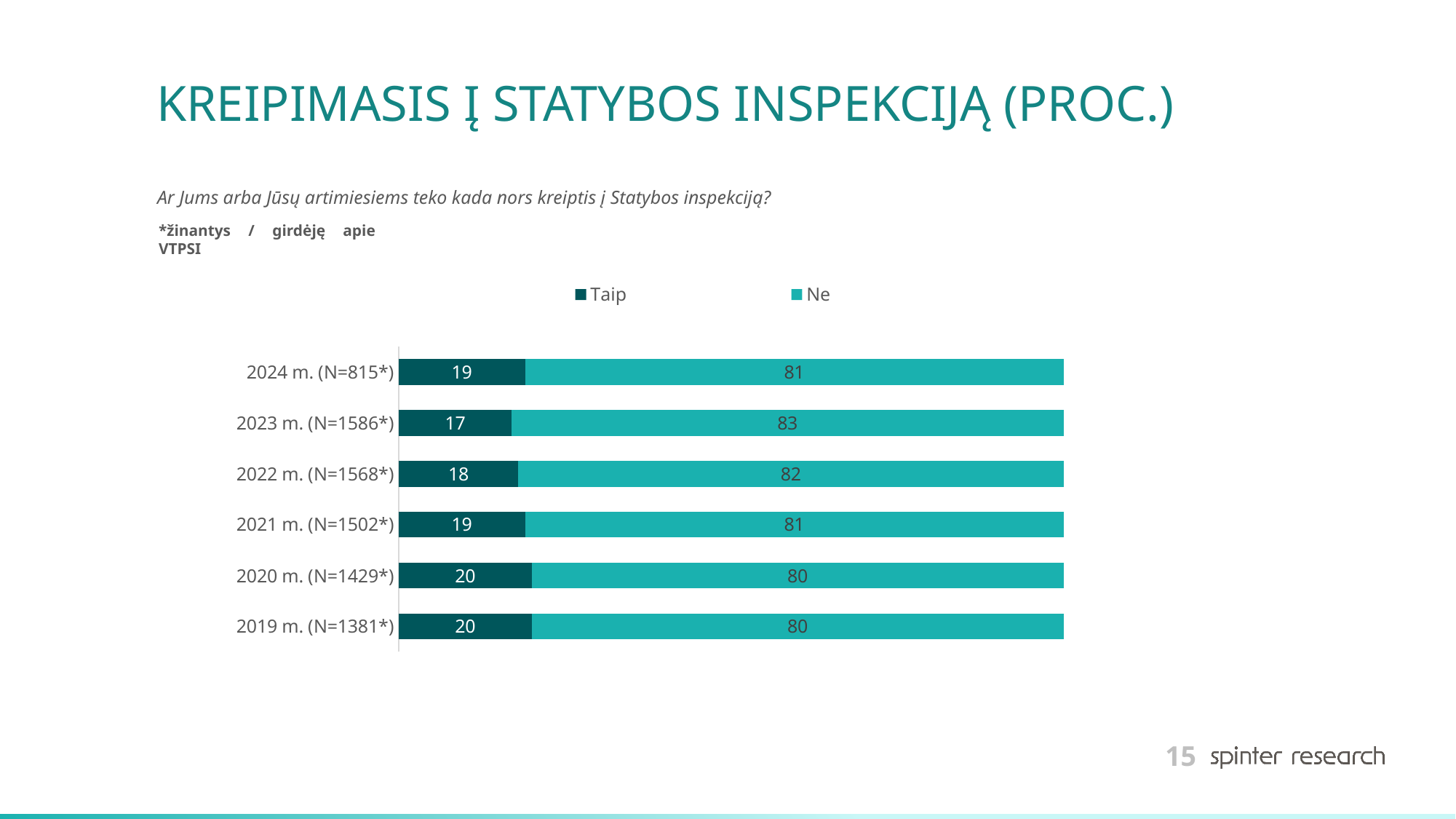
What is the value for Taip in 2024 m. (N=815*)? 19 How many series does the legend list? 2 How many years (categories) are shown in the chart? 6 What is the value for Taip in 2022 m. (N=1568*)? 18 Which is larger: the Taip value for 2020 m. (N=1429*) or the Taip value for 2022 m. (N=1568*)? 2020 m. (N=1429*) What is the difference between the Ne value for 2023 m. (N=1586*) and the Ne value for 2019 m. (N=1381*)? 3 What is the value for Ne in 2023 m. (N=1586*)? 83 Which year has the highest value for Ne? 2023 m. (N=1586*) Which year has the lowest value for Taip? 2023 m. (N=1586*) What kind of chart is shown on the slide? Stacked bar chart What are the two legend entries in the chart? Taip and Ne What is the total of the stacked bar for 2021 m. (N=1502*)? 100